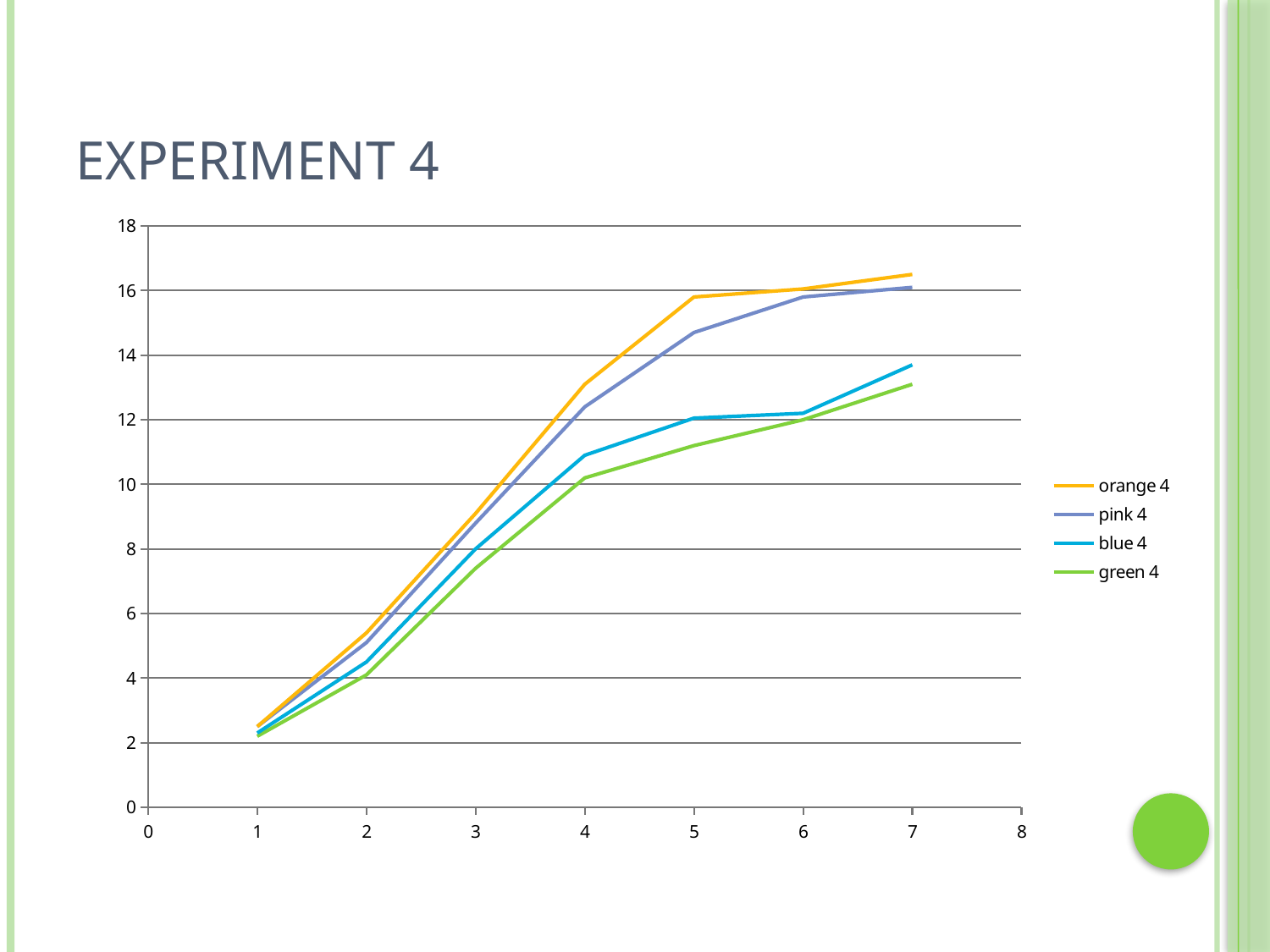
Is the value for orange 4 at x = 5 greater or less than 14? greater Is the value for green 4 at x = 4 greater or less than 12? less Which series has the highest value at x = 7? orange 4 At x = 4, which is larger: the value for pink 4 or the value for blue 4? pink 4 How many series does the legend list? 4 How many data points does the orange 4 series have? 7 What kind of chart is shown on the slide? line chart Do the values of the green 4 series rise or fall as x increases from 1 to 7? rise At x = 5, which is larger: the value for orange 4 or the value for green 4? orange 4 Which series has the lowest value at x = 4? green 4 Is the value for blue 4 at x = 7 greater or less than 12? greater What is the title of the slide containing the chart? EXPERIMENT 4